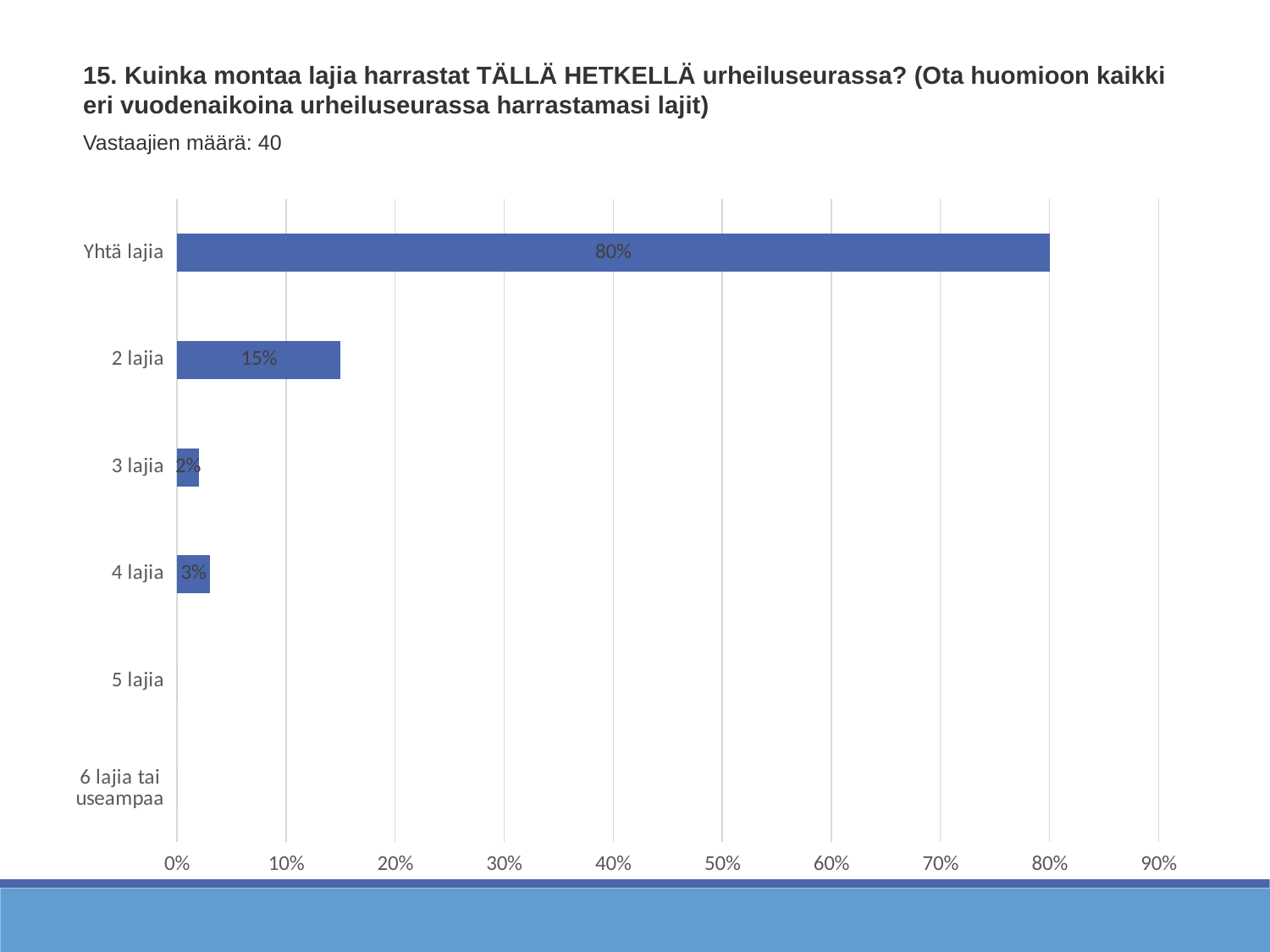
Is the value for "Yhtä lajia" greater or less than 70%? greater What percentage of respondents chose "Yhtä lajia"? 80% Which category has the highest value? Yhtä lajia How many categories are shown on the chart? 6 What is the value shown for "4 lajia"? 3% What is the value shown for "2 lajia"? 15% What kind of chart is shown on the slide? Bar chart What is the value shown for "3 lajia"? 2% How many respondents (Vastaajien määrä) does the slide report? 40 What is the difference between the values for "Yhtä lajia" and "2 lajia"? 65% Is the value for "2 lajia" greater or less than 20%? less Which is larger, the value for "3 lajia" or the value for "4 lajia"? 4 lajia